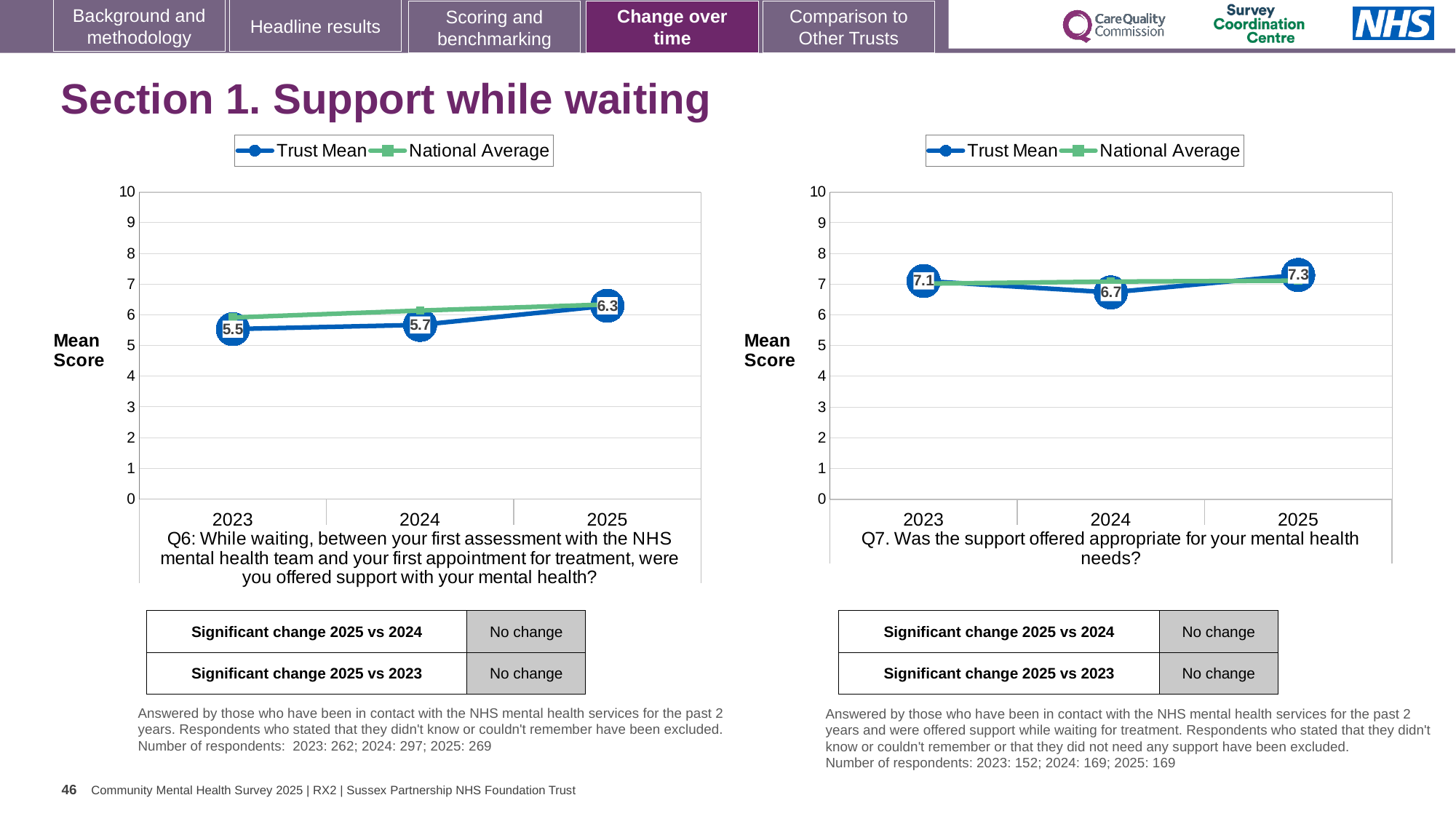
On the left chart (Q6), what is the Trust Mean score for 2023? 5.5 On the left chart (Q6), is the National Average for 2023 greater or less than 5? greater On the left chart (Q6), which year has the highest Trust Mean score? 2025 On the right chart (Q7), what is the Trust Mean score for 2024? 6.7 On the right chart (Q7), what is the Trust Mean score for 2025? 7.3 What kind of chart is the left chart (Q6)? line chart On the left chart (Q6), what is the difference between the Trust Mean scores for 2025 and 2023? 0.8 On the left chart (Q6), does the Trust Mean rise or fall from 2023 to 2025? rise How many series does the legend of the right chart (Q7) list? 2 On the right chart (Q7), which year has the lowest Trust Mean score? 2024 On the left chart (Q6), what is the Trust Mean score for 2025? 6.3 On the right chart (Q7), what is the difference between the Trust Mean scores for 2025 and 2024? 0.6